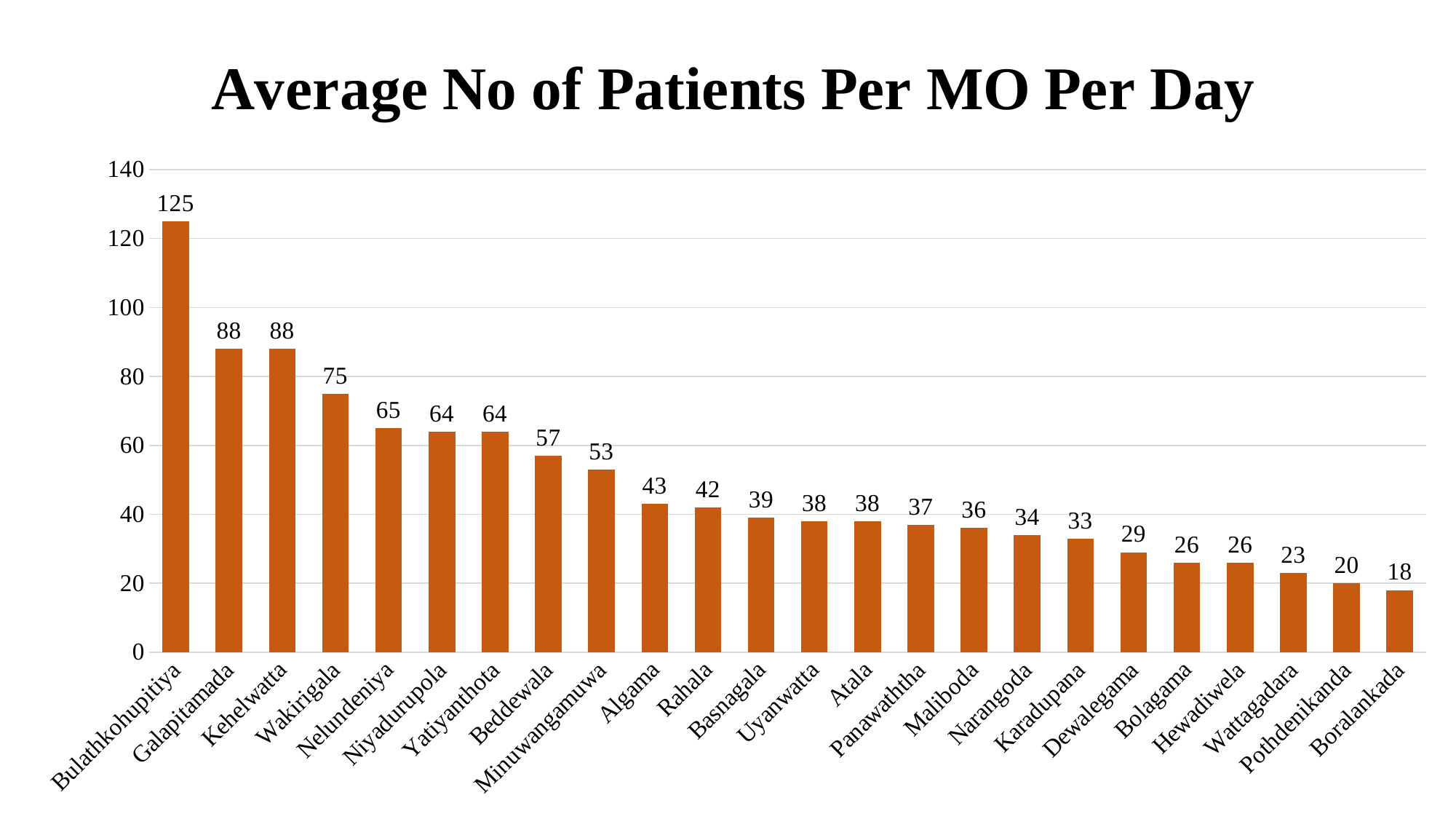
What is the difference between the values for Bulathkohupitiya and Galapitamada? 37 What is the average number of patients per MO per day for Wakirigala? 75 How many categories are shown on the x axis? 24 Is the value for Kehelwatta greater or less than 80? greater What is the value shown for Beddewala? 57 Which category has the lowest average number of patients per MO per day? Boralankada Which has a larger value, Nelundeniya or Minuwangamuwa? Nelundeniya What is the difference between the values for Algama and Dewalegama? 14 What is the title of the chart? Average No of Patients Per MO Per Day Which category has the highest average number of patients per MO per day? Bulathkohupitiya What is the value shown for Pothdenikanda? 20 What kind of chart is shown on the slide? Bar chart